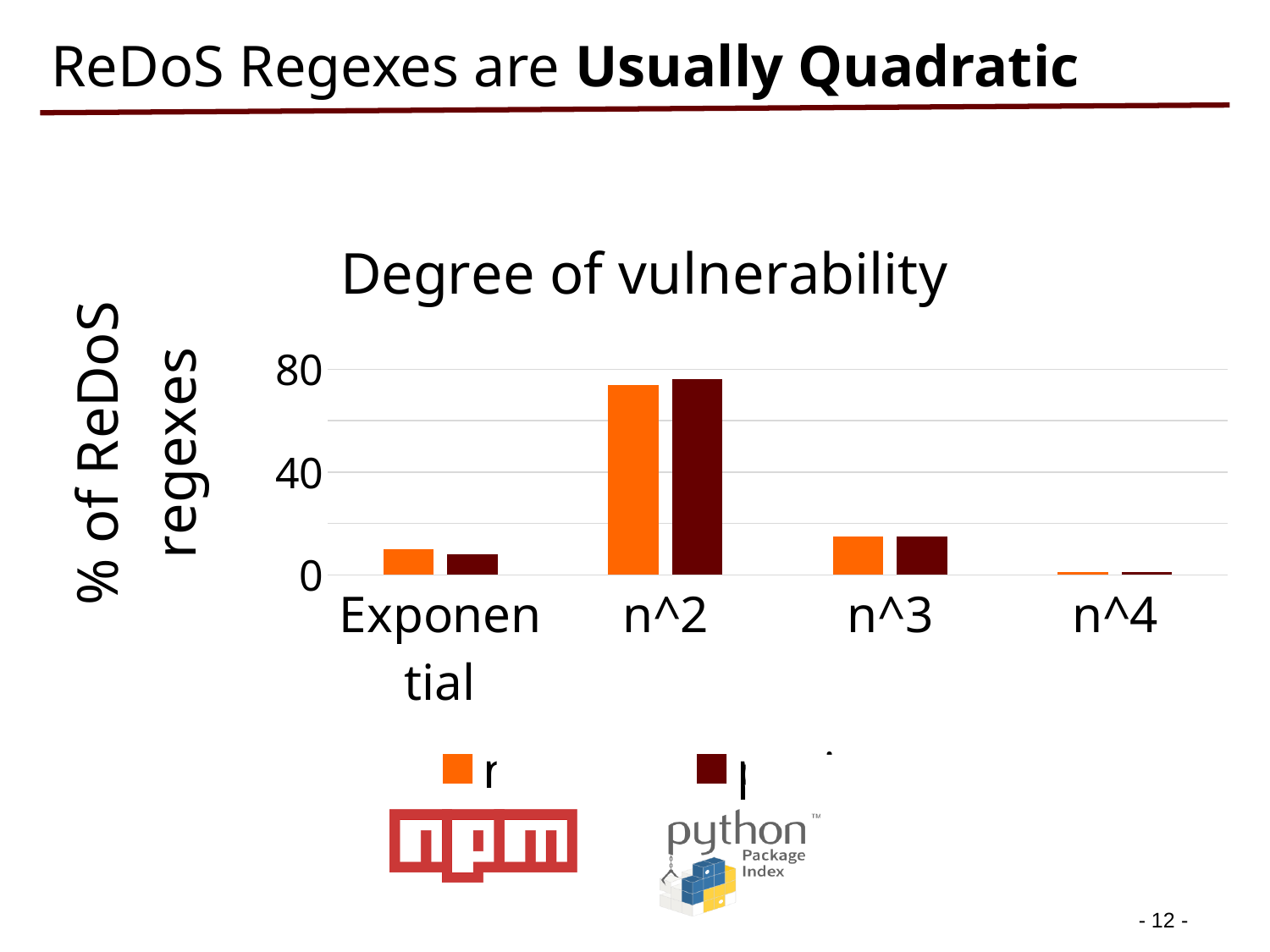
Is the dark red bar for Exponential greater or less than 40? less How many series does the chart's legend list? 2 Which category has the highest value for the orange series? n^2 How many categories are shown on the x axis of the chart? 4 For the orange series, which is larger: Exponential or n^4? Exponential What kind of chart is shown on the slide? bar chart What is the label on the vertical axis of the chart? % of ReDoS regexes For the dark red series, which is larger: n^2 or n^3? n^2 What is the title of the chart? Degree of vulnerability Which category has the lowest value for the dark red series? n^4 Is the orange bar for n^3 greater or less than 40? less Is the orange bar for n^2 greater or less than 40? greater